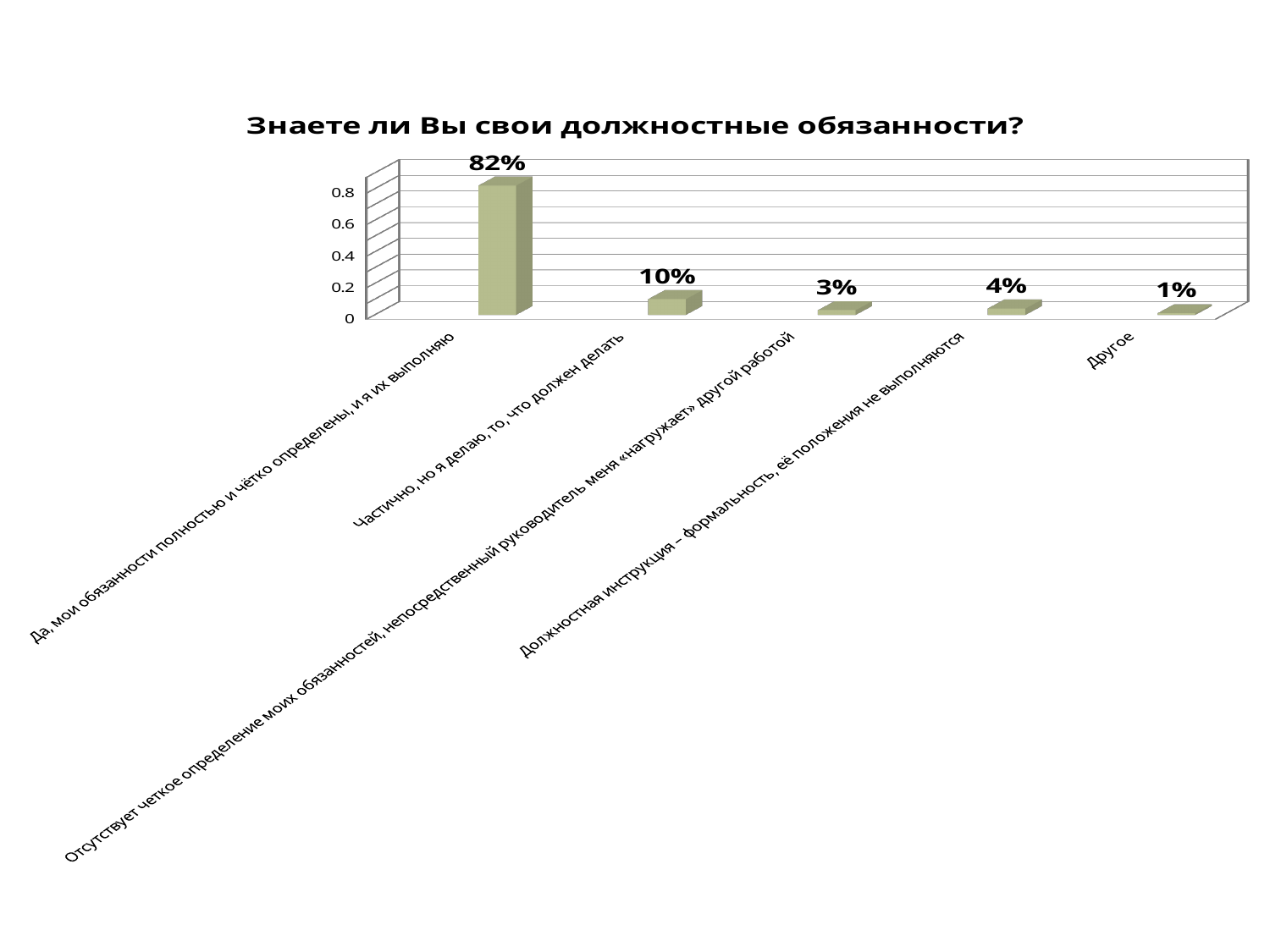
Is the value for "Да, мои обязанности полностью и чётко определены, и я их выполняю" greater or less than 0.6? greater How many categories are shown in the chart? 5 What is the value for the category "Должностная инструкция – формальность, её положения не выполняются"? 4% What kind of chart is shown on the slide? bar chart What is the value for the category "Да, мои обязанности полностью и чётко определены, и я их выполняю"? 82% Which category has the lowest value? Другое What is the value for the category "Другое"? 1% What is the value for the category "Частично, но я делаю то, что должен делать"? 10% Which is larger: the value for "Должностная инструкция – формальность, её положения не выполняются" or the value for "Отсутствует четкое определение моих обязанностей, непосредственный руководитель меня «нагружает» другой работой"? Должностная инструкция – формальность, её положения не выполняются Which category has the highest value? Да, мои обязанности полностью и чётко определены, и я их выполняю What is the title of the chart? Знаете ли Вы свои должностные обязанности? What is the difference between the values for "Да, мои обязанности полностью и чётко определены, и я их выполняю" and "Частично, но я делаю то, что должен делать"? 72%